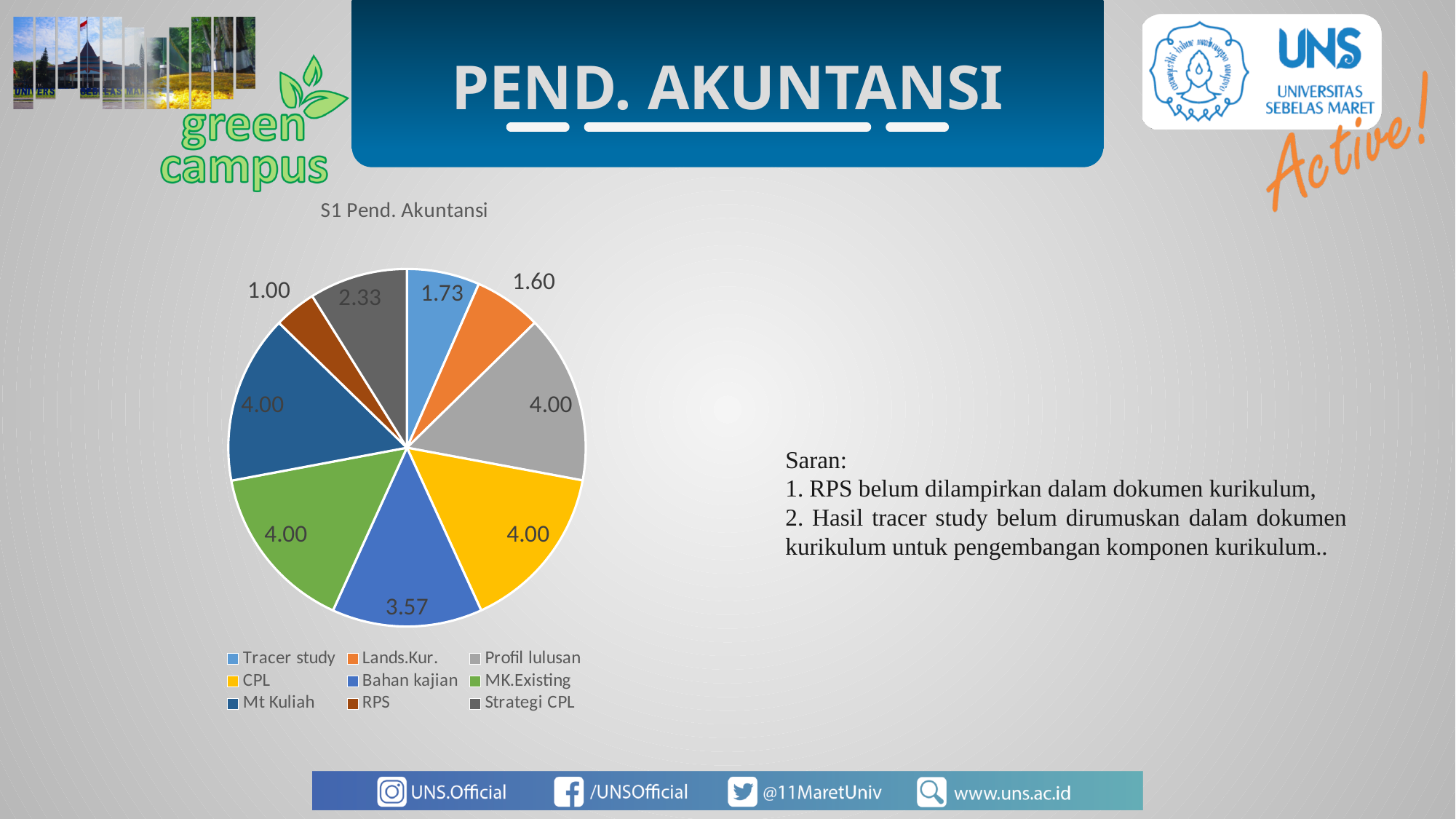
What is the difference between Strategi CPL and RPS? 1.33 What is the value for Bahan kajian? 3.57 Which is larger, Tracer study or Lands.Kur.? Tracer study Which category has the smallest slice? RPS What is the value for Tracer study? 1.73 What colour is the CPL slice? yellow How many categories does the pie chart have? 9 What is the value for Lands.Kur.? 1.60 What is the title of the chart? S1 Pend. Akuntansi What is the value for Strategi CPL? 2.33 What type of chart is shown on the slide? pie chart What is the value for RPS? 1.00